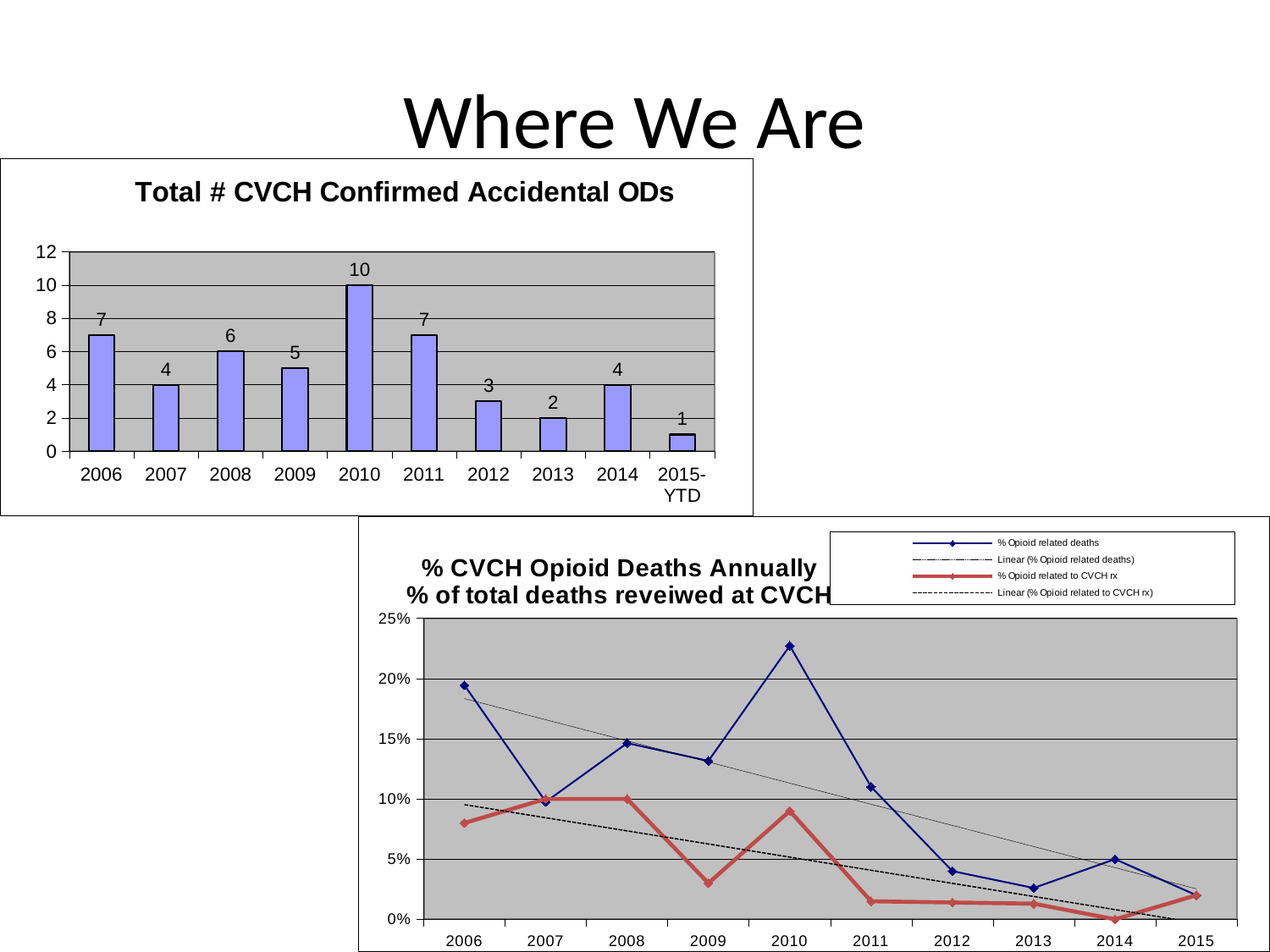
In the 'Total # CVCH Confirmed Accidental ODs' chart, what is the value for 2010? 10 How many categories are shown on the x axis of the 'Total # CVCH Confirmed Accidental ODs' chart? 10 What kind of chart is the 'Total # CVCH Confirmed Accidental ODs' chart? bar chart In the '% CVCH Opioid Deaths Annually' chart, is the value for '% Opioid related deaths' in 2010 greater or less than 20%? greater In the 'Total # CVCH Confirmed Accidental ODs' chart, what is the difference between the values for 2010 and 2011? 3 In the 'Total # CVCH Confirmed Accidental ODs' chart, what is the value for 2015-YTD? 1 In the 'Total # CVCH Confirmed Accidental ODs' chart, which is larger, the value for 2008 or the value for 2009? 2008 In the '% CVCH Opioid Deaths Annually' chart, is the value for '% Opioid related to CVCH rx' in 2009 greater or less than 5%? less In the 'Total # CVCH Confirmed Accidental ODs' chart, which year has the highest value? 2010 In the 'Total # CVCH Confirmed Accidental ODs' chart, which category has the lowest value? 2015-YTD What kind of chart is the '% CVCH Opioid Deaths Annually' chart? line chart How many entries does the legend of the '% CVCH Opioid Deaths Annually' chart list? 4